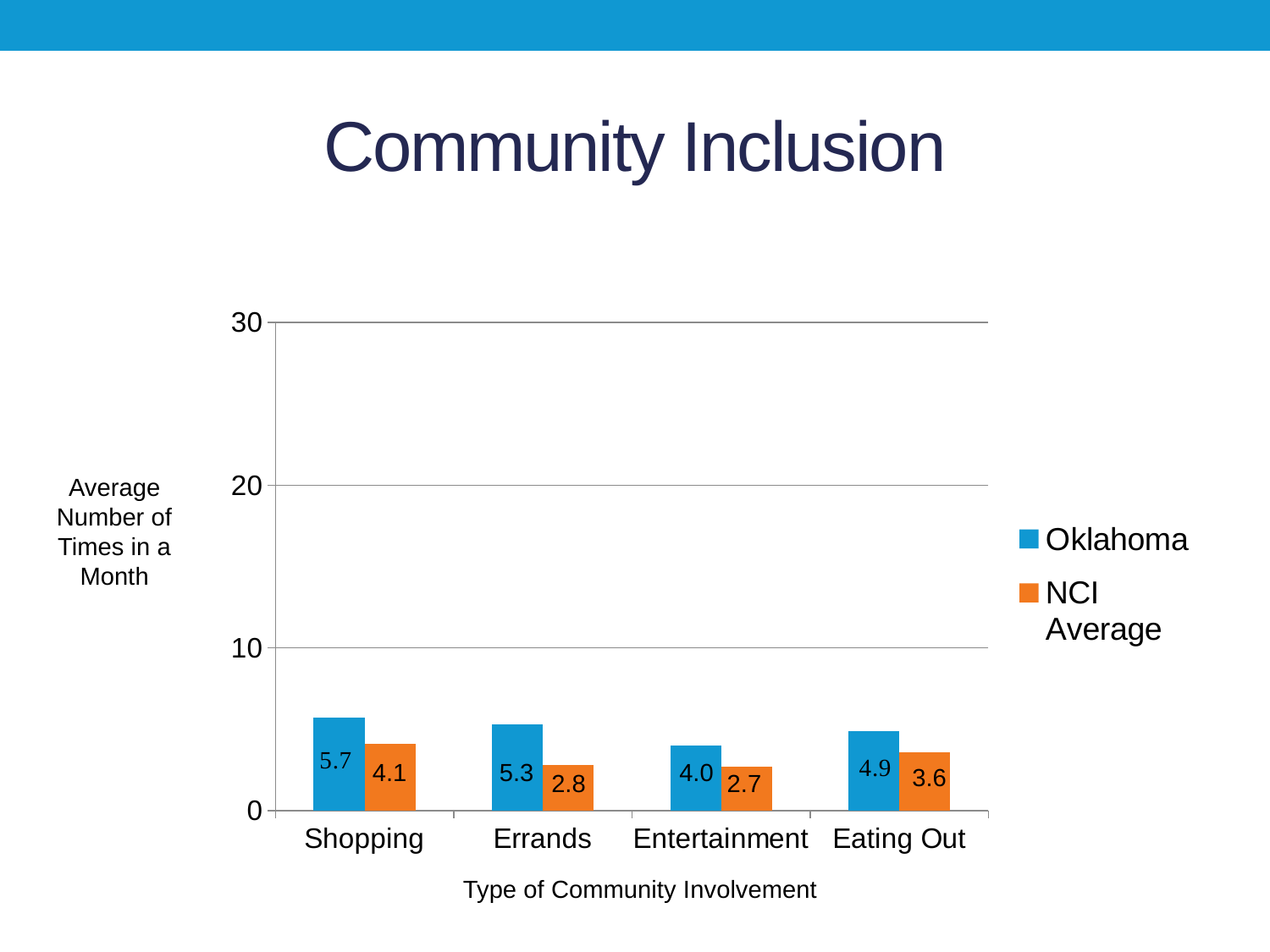
What is the Oklahoma value for Shopping? 5.7 Which category has the highest Oklahoma value? Shopping Which category has the lowest NCI Average value? Entertainment What is the difference between the Oklahoma and NCI Average values for Errands? 2.5 What is the NCI Average value for Entertainment? 2.7 Is the Oklahoma value for Shopping greater or less than 10? less What is the NCI Average value for Eating Out? 3.6 How many categories are shown on the x axis? 4 Which is larger for Eating Out, the Oklahoma value or the NCI Average value? Oklahoma What is the title of the chart? Community Inclusion What kind of chart is shown on the slide? bar chart How many series does the legend list? 2